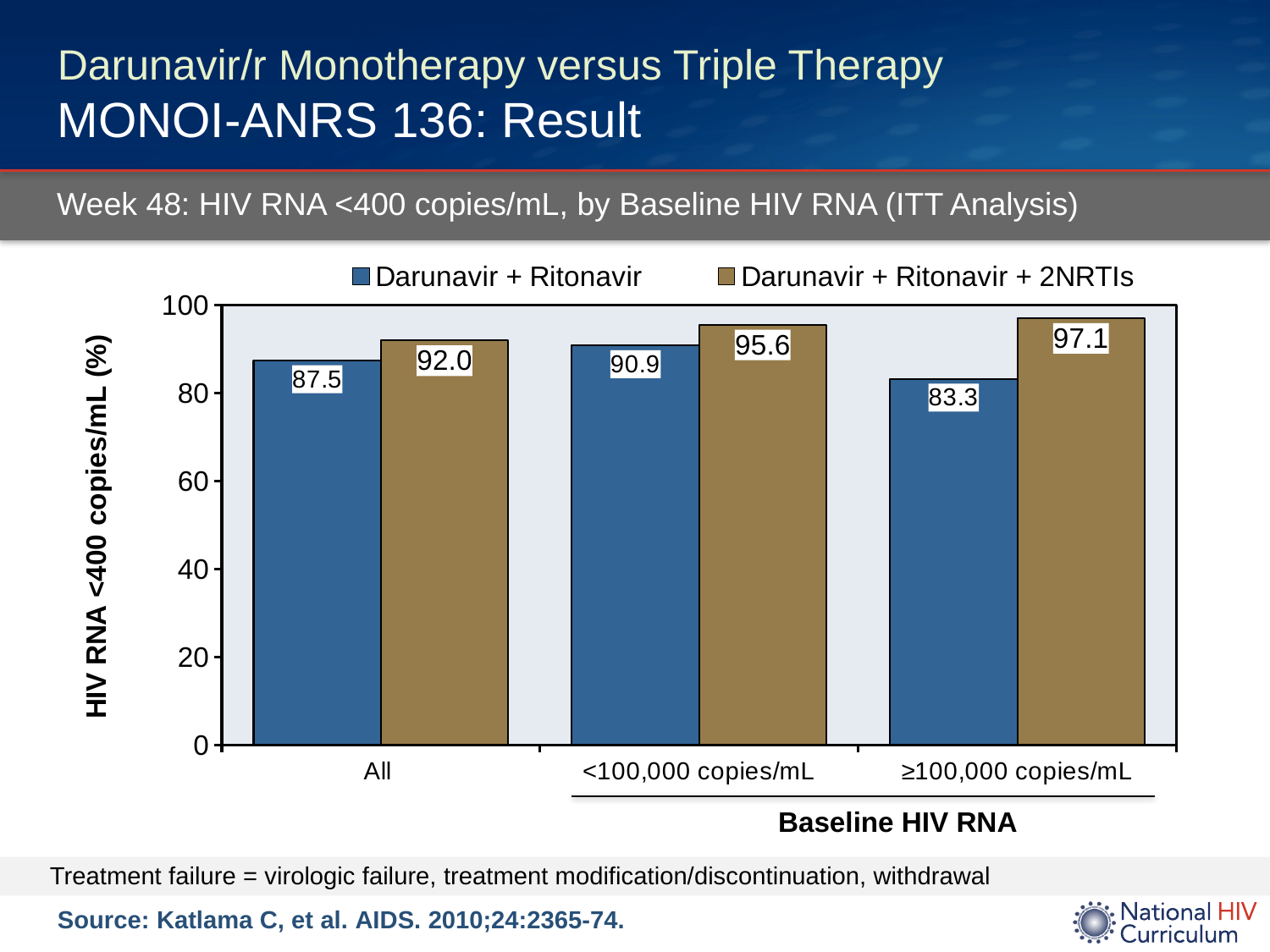
In the <100,000 copies/mL category, which series has the larger value? Darunavir + Ritonavir + 2NRTIs What is the value for Darunavir + Ritonavir in the <100,000 copies/mL category? 90.9 What kind of chart is shown on the slide? bar chart What is the value for Darunavir + Ritonavir in the All category? 87.5 What is the difference between the Darunavir + Ritonavir + 2NRTIs and Darunavir + Ritonavir values in the All category? 4.5 What is the difference between the Darunavir + Ritonavir + 2NRTIs and Darunavir + Ritonavir values in the ≥100,000 copies/mL category? 13.8 How many series does the legend list? 2 What is the value for Darunavir + Ritonavir + 2NRTIs in the ≥100,000 copies/mL category? 97.1 How many categories are shown on the x axis? 3 Is the value for Darunavir + Ritonavir in the ≥100,000 copies/mL category greater or less than 80? greater Which category has the highest value for Darunavir + Ritonavir + 2NRTIs? ≥100,000 copies/mL Which category has the lowest value for Darunavir + Ritonavir? ≥100,000 copies/mL